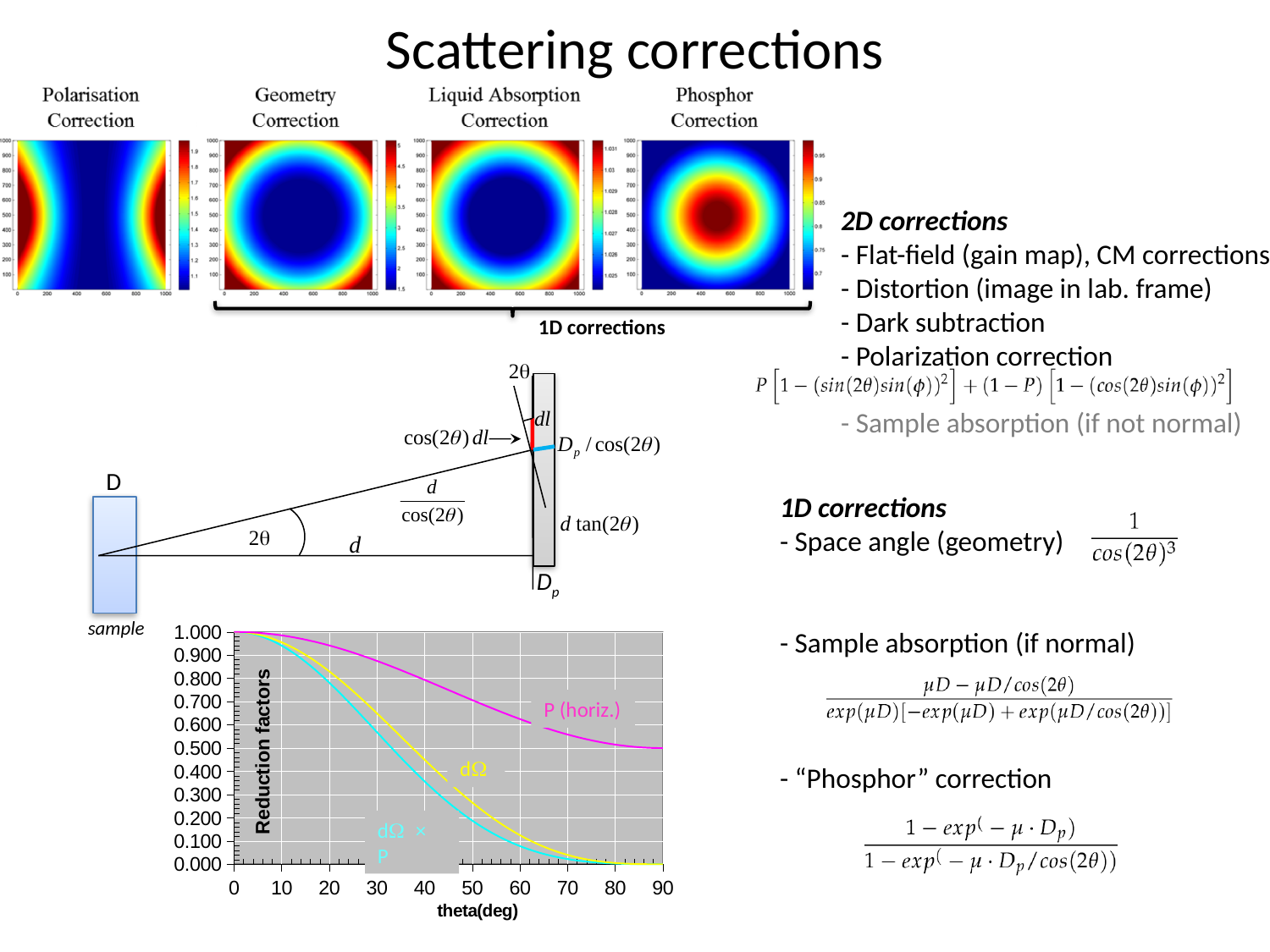
What is the x-axis label of the 'Reduction factors' chart? theta(deg) How many series are plotted in the 'Reduction factors' chart? 3 In the 'Reduction factors' chart, what is the value of the dΩ curve at theta = 90 degrees? 0.000 In the 'Reduction factors' chart, which series has the lowest value at theta = 50 degrees? dΩ × P In the 'Reduction factors' chart, is the value of P (horiz.) at theta = 40 degrees greater or less than 0.500? greater In the 'Reduction factors' chart, is the value of dΩ at theta = 50 degrees greater or less than 0.500? less What kind of chart is the 'Reduction factors' plot at the bottom left of the slide? line chart In the 'Reduction factors' chart, which series has the higher value at theta = 60 degrees: P (horiz.) or dΩ? P (horiz.) In the 'Reduction factors' chart, what value do all three curves start at when theta = 0? 1.000 In the 'Reduction factors' chart, do the values rise or fall as theta increases from 0 to 90 degrees? fall In the 'Reduction factors' chart, is the value of dΩ × P at theta = 40 degrees greater or less than 0.500? less In the 'Reduction factors' chart, what is the value of P (horiz.) at theta = 90 degrees? 0.500